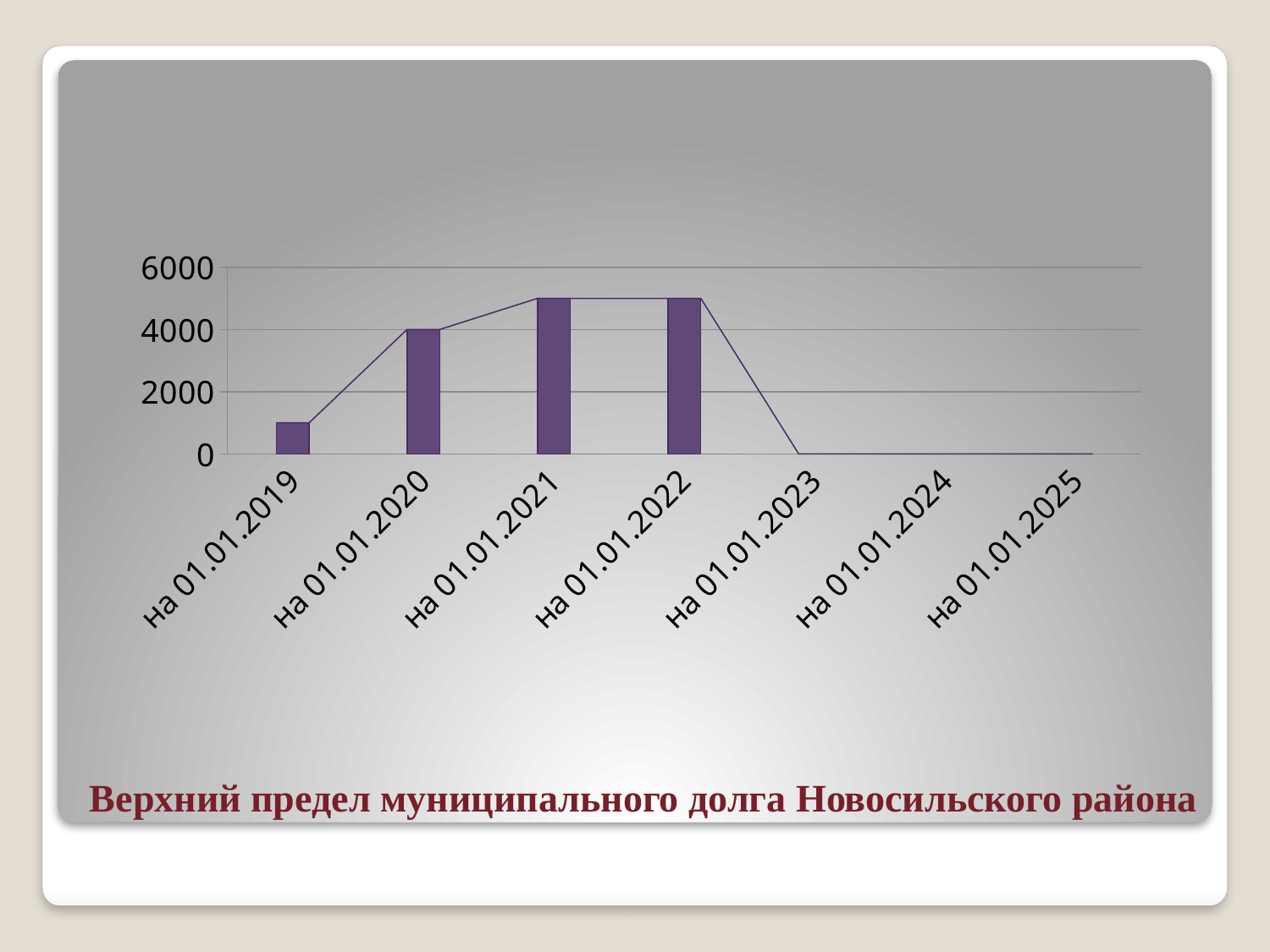
What is the title of the chart? Верхний предел муниципального долга Новосильского района Is the value for на 01.01.2019 greater or less than 2000? less What kind of chart is shown on the slide? bar chart What is the value for на 01.01.2020? 4000 Is the value for на 01.01.2022 greater or less than 6000? less How many categories are shown on the x axis? 7 Do the values rise or fall from на 01.01.2019 to на 01.01.2021? rise Which is larger, the value for на 01.01.2019 or the value for на 01.01.2020? на 01.01.2020 What is the value for на 01.01.2023? 0 Is the value for на 01.01.2021 greater or less than 4000? greater What is the difference between the value for на 01.01.2020 and the value for на 01.01.2023? 4000 What is the value for на 01.01.2025? 0